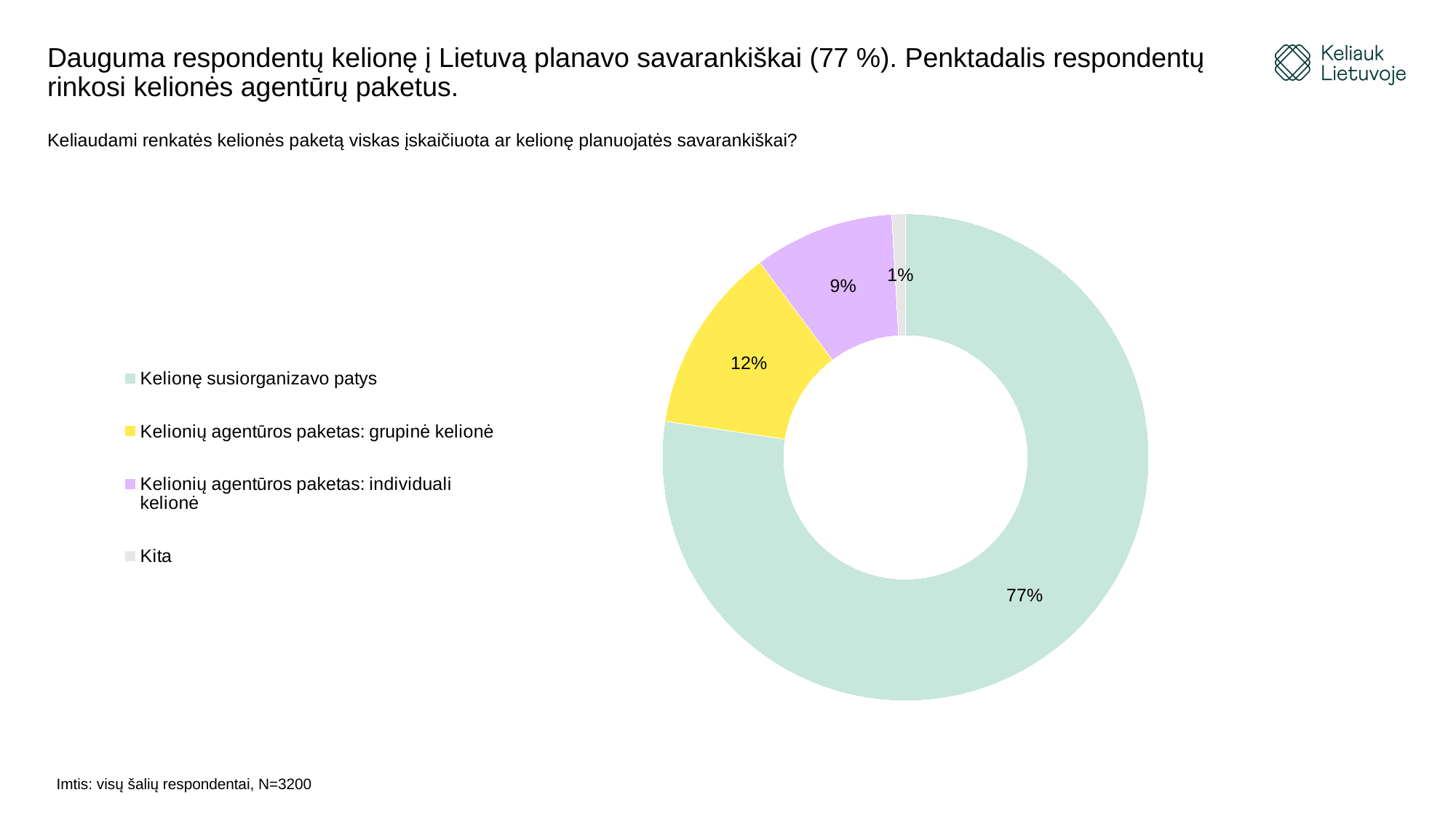
What is the combined share of the two travel agency package categories? 21% Which category has the largest share in the chart? Kelionę susiorganizavo patys What share of respondents is shown for "Kelionių agentūros paketas: grupinė kelionė"? 12% What share of respondents is shown for "Kelionę susiorganizavo patys"? 77% What kind of chart is shown on the slide? Pie chart (doughnut) How many categories does the chart show? 4 Which category has the smallest share in the chart? Kita What colour is the slice for "Kelionių agentūros paketas: grupinė kelionė"? Yellow What is the difference in percentage points between "Kelionių agentūros paketas: grupinė kelionė" and "Kelionių agentūros paketas: individuali kelionė"? 3 percentage points What share of respondents is shown for "Kita"? 1% Which is larger: the share for "Kelionių agentūros paketas: grupinė kelionė" or for "Kelionių agentūros paketas: individuali kelionė"? Kelionių agentūros paketas: grupinė kelionė What share of respondents is shown for "Kelionių agentūros paketas: individuali kelionė"? 9%